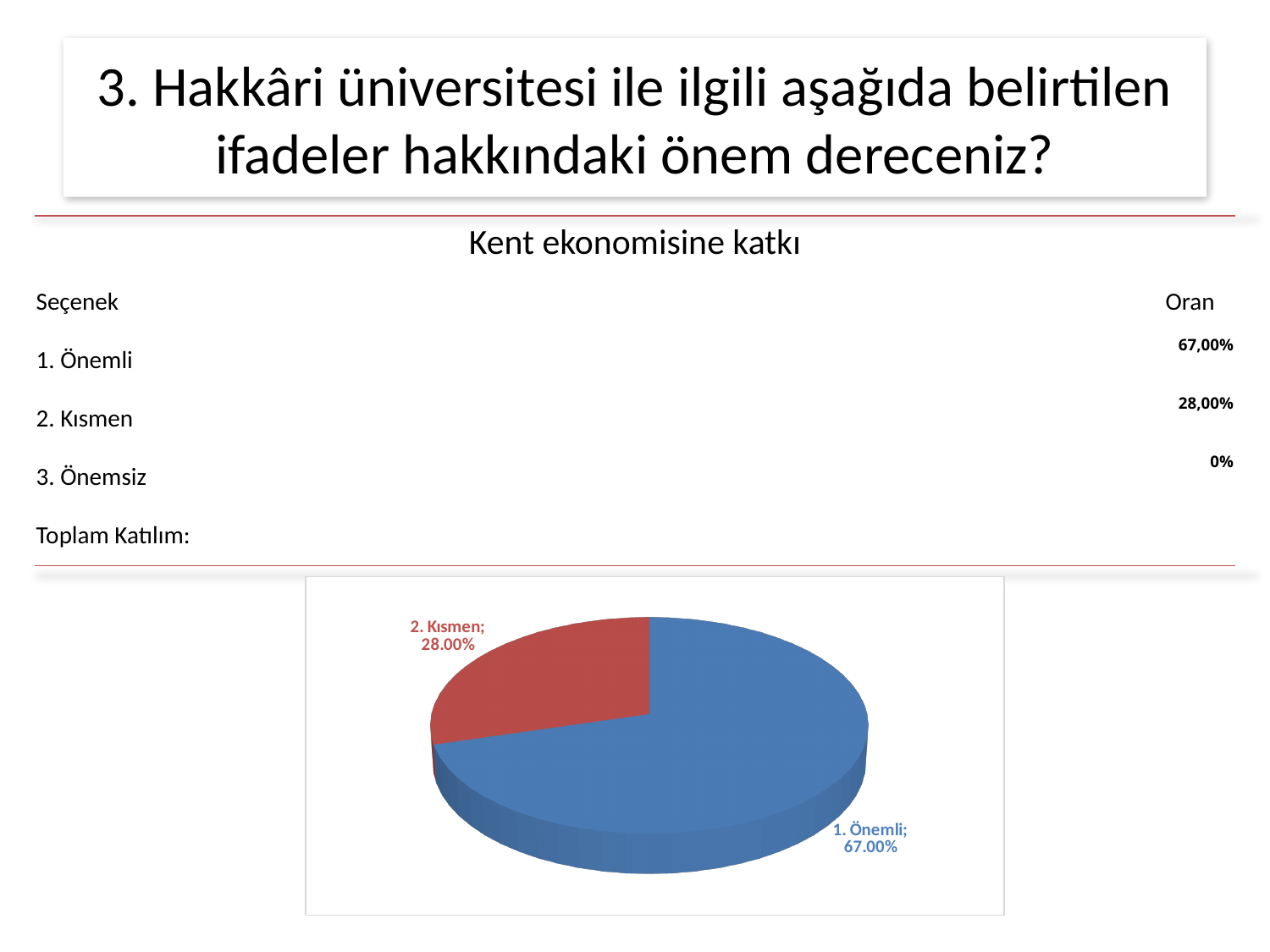
What is the value shown for the "2. Kısmen" slice of the pie chart? 28.00% What colour is the "2. Kısmen" slice of the pie chart? red Which slice of the pie chart is the largest? 1. Önemli Which is larger in the pie chart, "1. Önemli" or "2. Kısmen"? 1. Önemli What is the difference between the "1. Önemli" and "2. Kısmen" values in the pie chart? 39.00% What colour is the "1. Önemli" slice of the pie chart? blue What is the value shown for the "1. Önemli" slice of the pie chart? 67.00% Which labelled slice of the pie chart is the smallest? 2. Kısmen What share of the pie does the "2. Kısmen" slice represent? 28.00% Is the value for "1. Önemli" in the pie chart greater or less than 50%? greater What kind of chart is shown on the slide? pie chart How many labelled slices does the pie chart have? 2